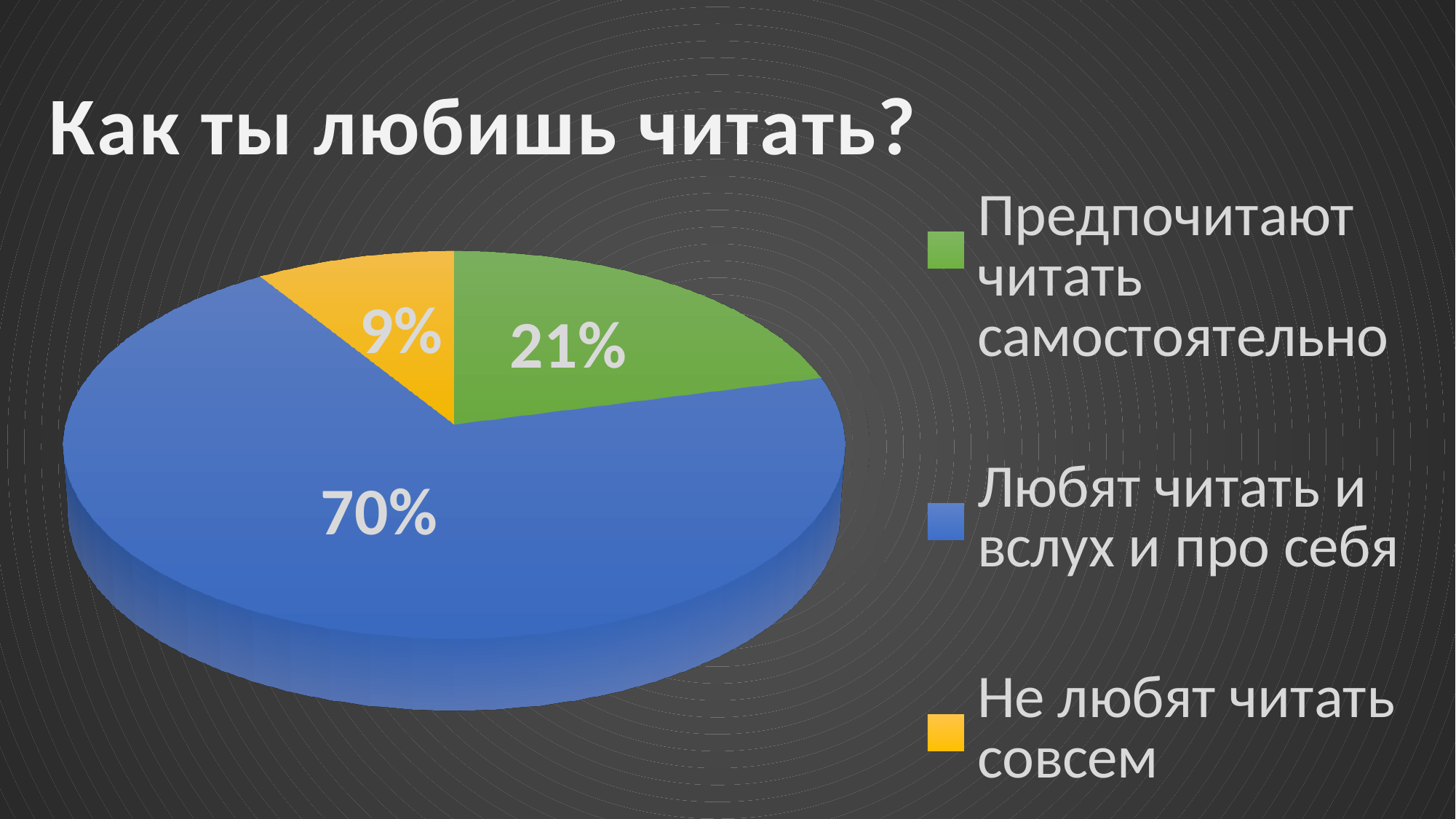
What is the title of the slide? Как ты любишь читать? What is the difference in percentage points between "Предпочитают читать самостоятельно" and "Не любят читать совсем"? 12 What share of the pie is labelled "Любят читать и вслух и про себя"? 70% How many slices does the pie chart have? 3 Which category has the largest slice of the pie? Любят читать и вслух и про себя What kind of chart is shown on the slide? Pie chart What colour is the slice for "Не любят читать совсем"? Yellow What is the difference in percentage points between "Любят читать и вслух и про себя" and "Предпочитают читать самостоятельно"? 49 Which is larger: the slice for "Предпочитают читать самостоятельно" or the slice for "Не любят читать совсем"? Предпочитают читать самостоятельно What share of the pie is labelled "Предпочитают читать самостоятельно"? 21% Which category has the smallest slice of the pie? Не любят читать совсем What share of the pie is labelled "Не любят читать совсем"? 9%